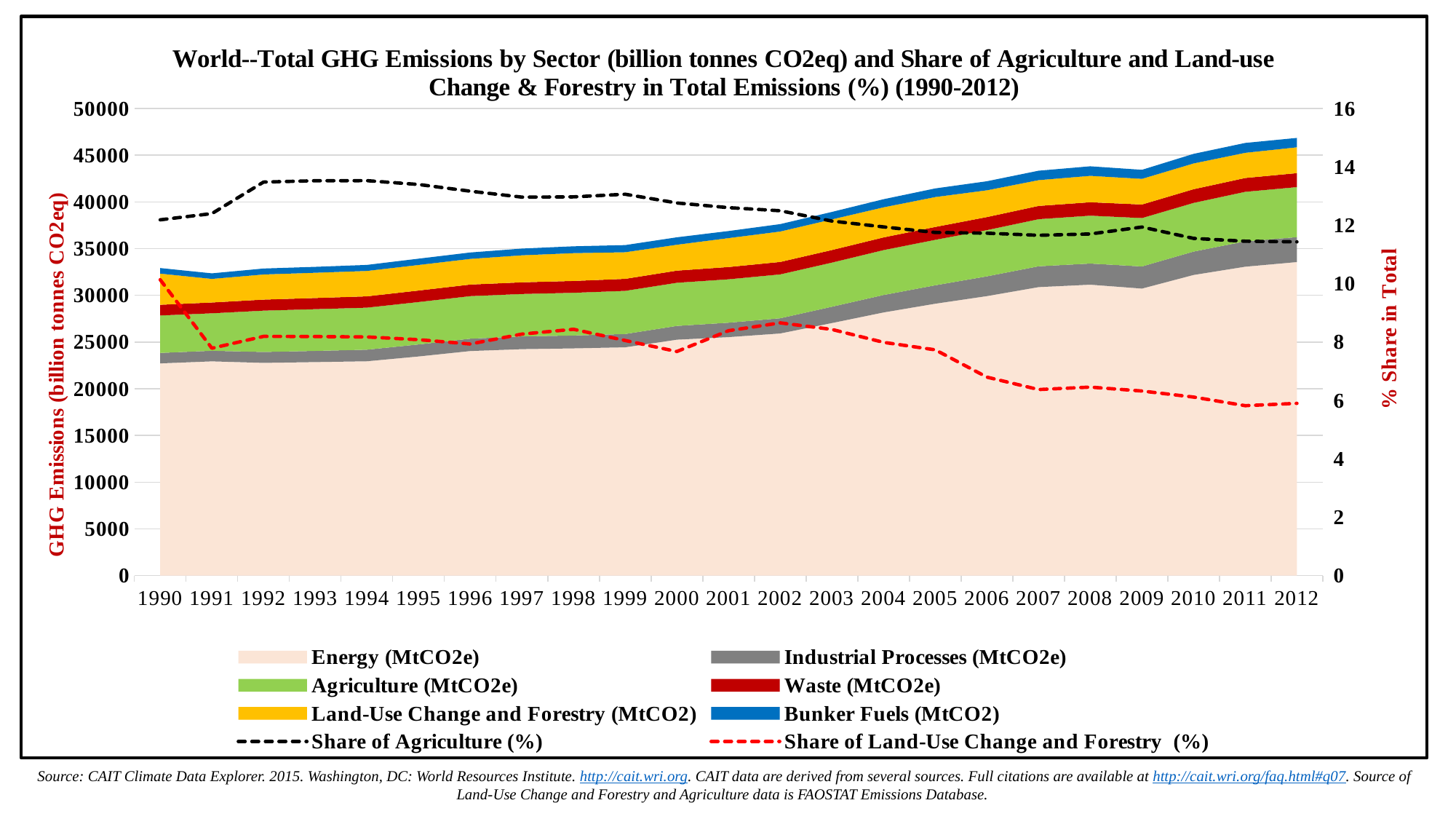
What is the label of the right-hand vertical axis? % Share in Total Is the total stacked emissions value in 2012 greater or less than 45000? greater What kind of chart is shown on the slide? Stacked area chart with dashed line series Does the Share of Land-Use Change and Forestry (%) line rise or fall from 1990 to 2012? Fall How many series does the legend list? 8 Is the total stacked emissions value in 1990 greater or less than 35000? less Do total GHG emissions rise or fall from 1990 to 2012? Rise What is the first year shown on the x axis? 1990 In 2012, which is larger: the Share of Agriculture (%) or the Share of Land-Use Change and Forestry (%)? Share of Agriculture (%) Is the Share of Land-Use Change and Forestry (%) in 2012 greater or less than 8? less How many years are plotted along the x axis? 23